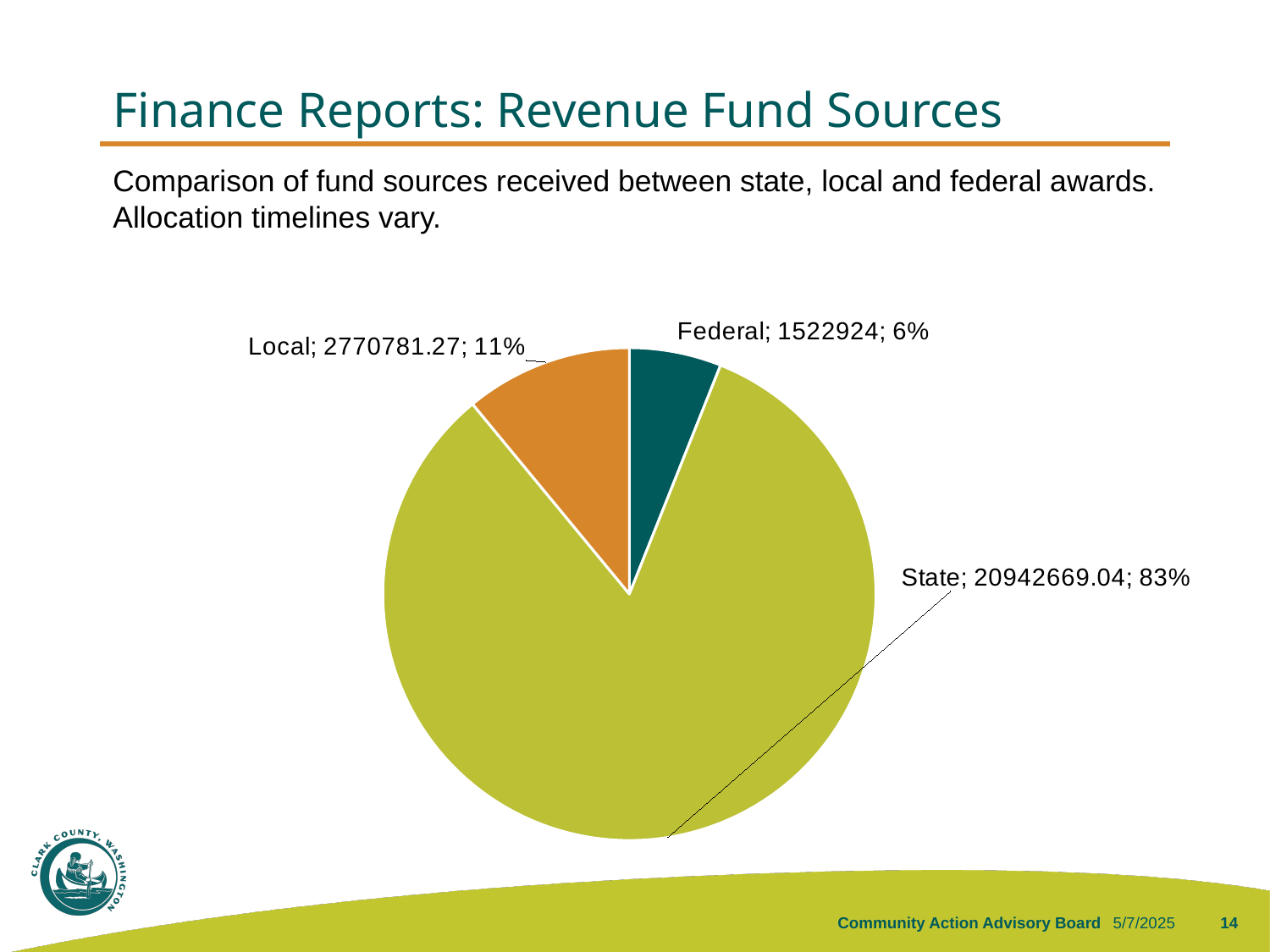
What is the difference between the Local value and the Federal value? 1247857.27 What is the value for State in the pie chart? 20942669.04 What share of the pie does State represent? 83% What is the value for Local in the pie chart? 2770781.27 Which fund source has the largest slice of the pie? State What colour is the State slice in the pie chart? green What is the value for Federal in the pie chart? 1522924 Which fund source has the smallest slice of the pie? Federal What type of chart is shown on the slide? pie chart How many slices does the pie chart have? 3 Which is larger, the Local value or the Federal value? Local What share of the pie does Local represent? 11%